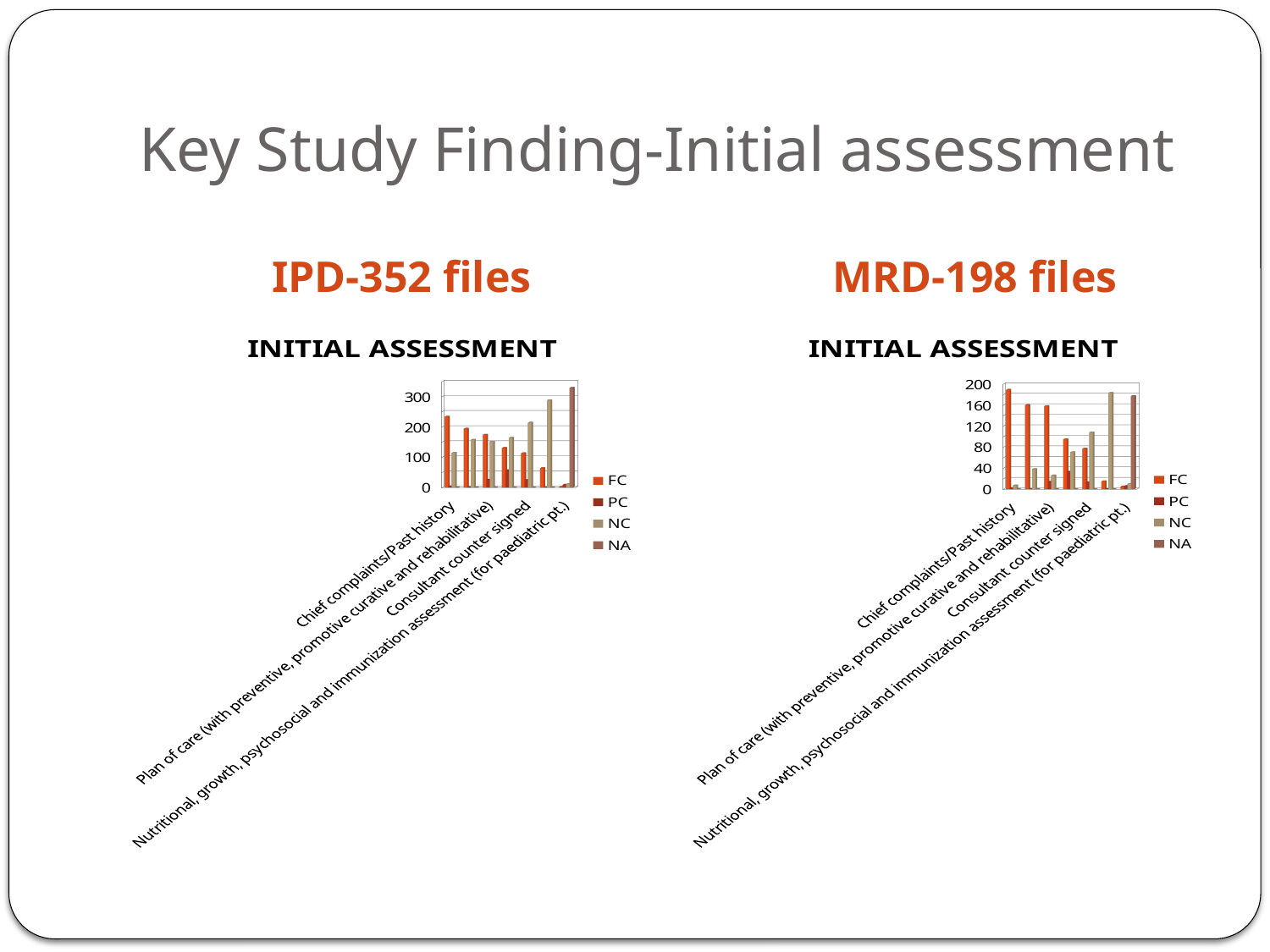
In the IPD-352 files chart, which series has the single tallest bar? NA In the MRD-198 files chart, is the FC value for Chief complaints/Past history greater or less than 160? greater In the IPD-352 files chart, is the tallest NA bar greater or less than 300? greater What are the legend entries of the IPD-352 files INITIAL ASSESSMENT chart? FC, PC, NC, NA What kind of chart is the IPD-352 files INITIAL ASSESSMENT chart? bar chart In the IPD-352 files chart, is the NC value for Chief complaints/Past history greater or less than 200? less In the MRD-198 files chart, do the FC bars rise or fall moving from left to right across the categories? fall How many series does the legend of the MRD-198 files INITIAL ASSESSMENT chart list? 4 In the IPD-352 files chart, which is larger for Chief complaints/Past history, the FC bar or the NC bar? FC In the MRD-198 files chart, which is larger for Chief complaints/Past history, the FC bar or the PC bar? FC